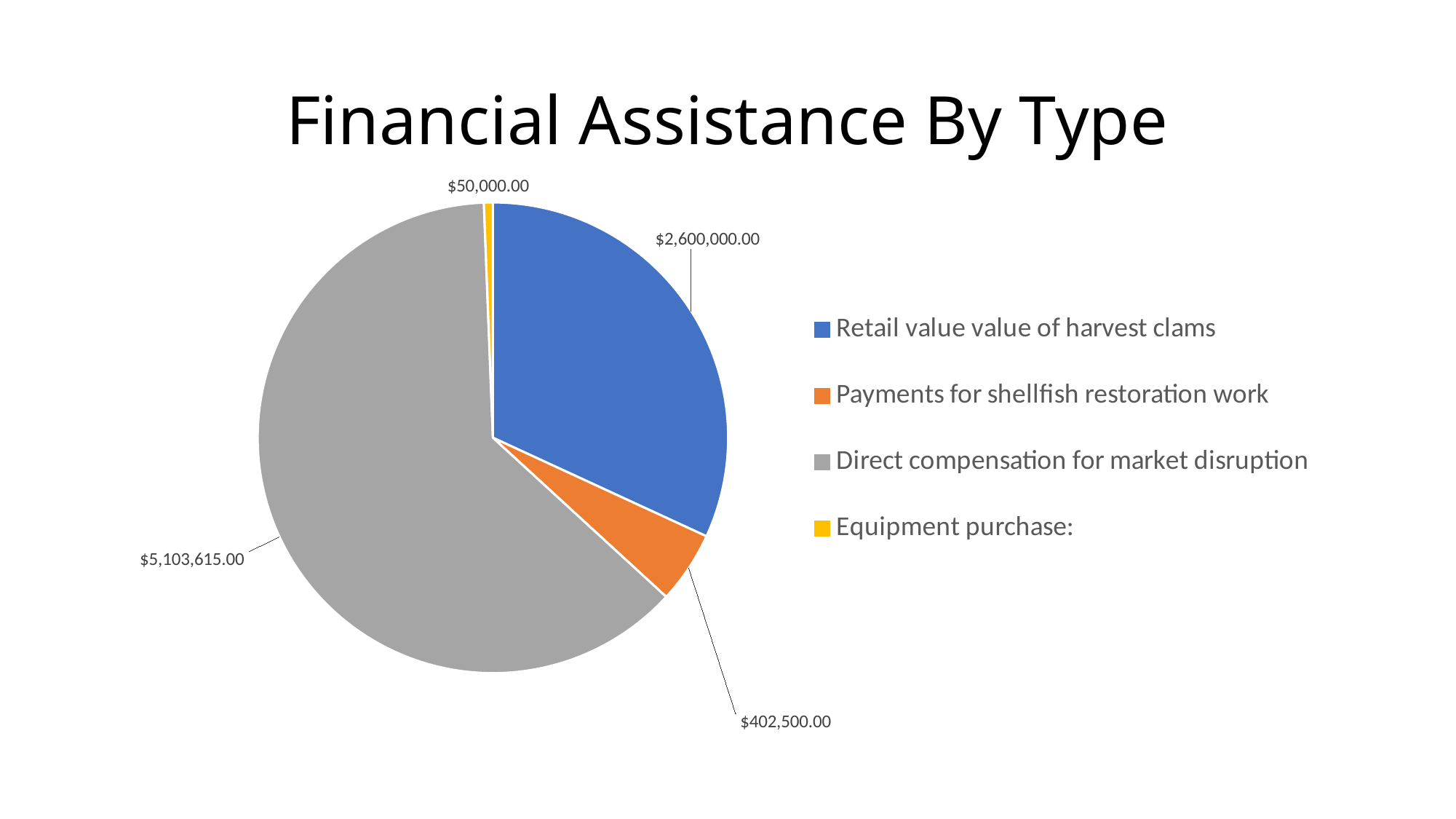
What is the value for Direct compensation for market disruption? $5,103,615.00 What is the difference between Retail value value of harvest clams and Payments for shellfish restoration work? $2,197,500.00 Which is larger, Payments for shellfish restoration work or Equipment purchase? Payments for shellfish restoration work What is the title of the chart? Financial Assistance By Type Which category has the smallest slice of the pie? Equipment purchase: What is the value for Retail value value of harvest clams? $2,600,000.00 What is the difference between Direct compensation for market disruption and Retail value value of harvest clams? $2,503,615.00 How many categories are shown in the pie chart? 4 What kind of chart is shown on the slide? Pie chart What is the value for Payments for shellfish restoration work? $402,500.00 Which category has the largest slice of the pie? Direct compensation for market disruption What is the value for Equipment purchase? $50,000.00